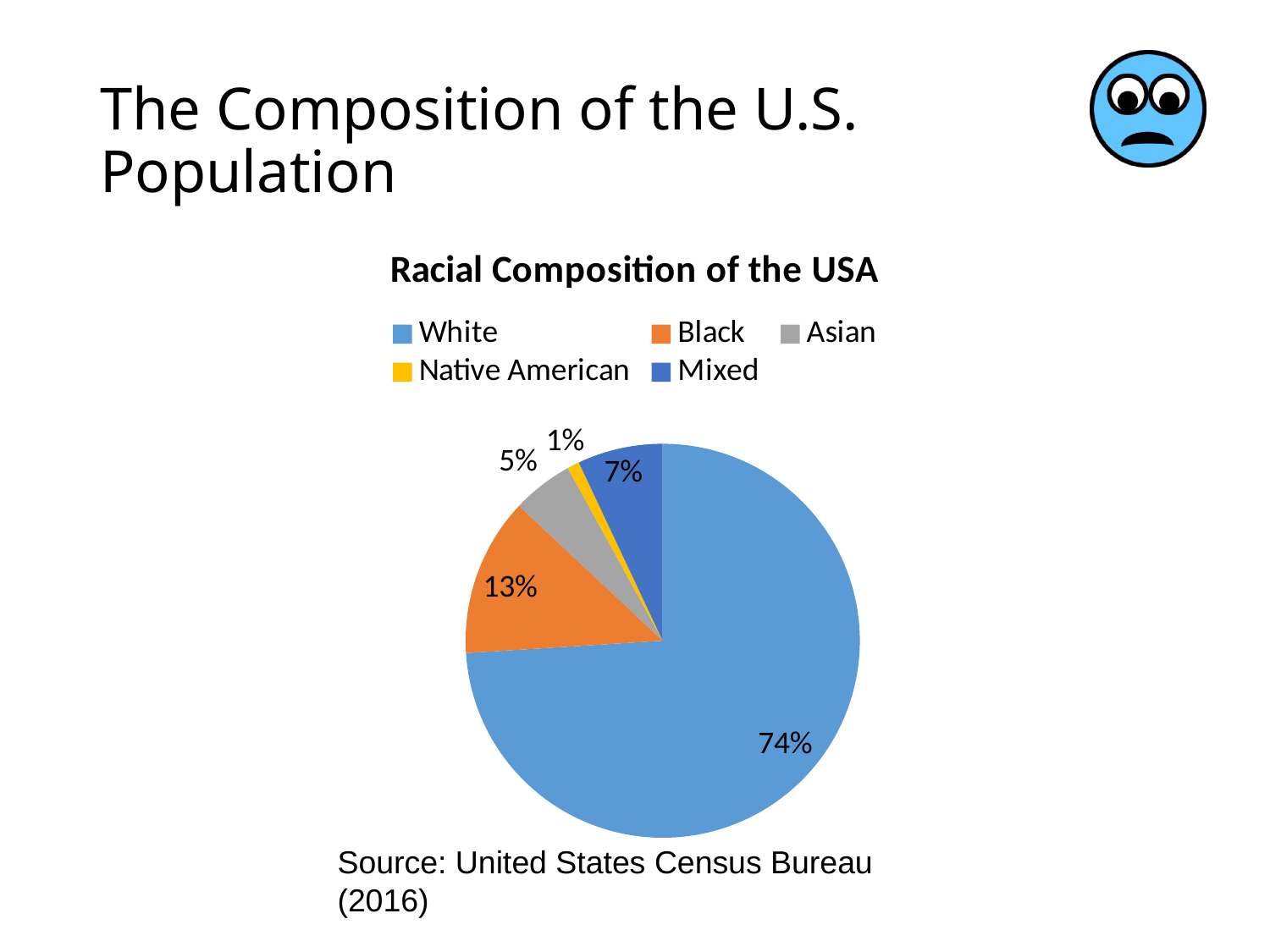
Which slice is larger, Mixed or Asian? Mixed What share of the pie does Asian represent? 5% What share of the pie does White represent? 74% What kind of chart is shown on the slide? Pie chart What share of the pie does Black represent? 13% Which category has the smallest slice of the pie? Native American What is the difference in percentage points between the White and Black slices? 61 How many categories are shown in the pie chart? 5 What is the title of the chart? Racial Composition of the USA Which category has the largest slice of the pie? White What share of the pie does Native American represent? 1% What share of the pie does Mixed represent? 7%